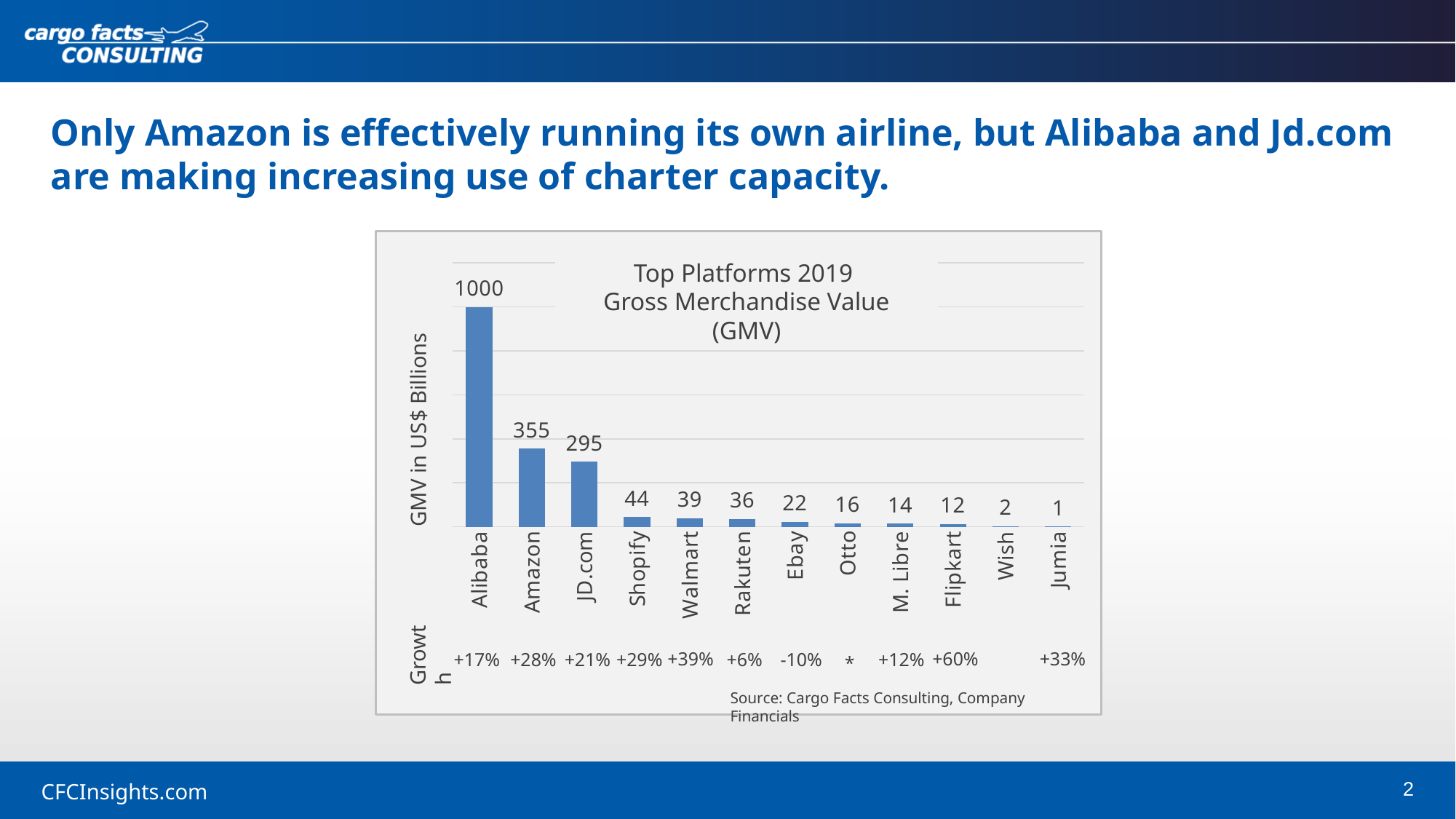
Which platform has the lowest GMV in the chart? Jumia What is the difference in GMV between Amazon and JD.com? 60 How many platforms are shown in the chart? 12 What is the GMV value shown for Flipkart? 12 What is the title of the chart? Top Platforms 2019 Gross Merchandise Value (GMV) What is the GMV value shown for Shopify? 44 What is the growth figure shown for Flipkart? +60% Which platform has the highest GMV in the chart? Alibaba What is the GMV value shown for Amazon? 355 What is the GMV value shown for Alibaba? 1000 What kind of chart is shown on the slide? Bar chart Which has a larger GMV, Walmart or Rakuten? Walmart